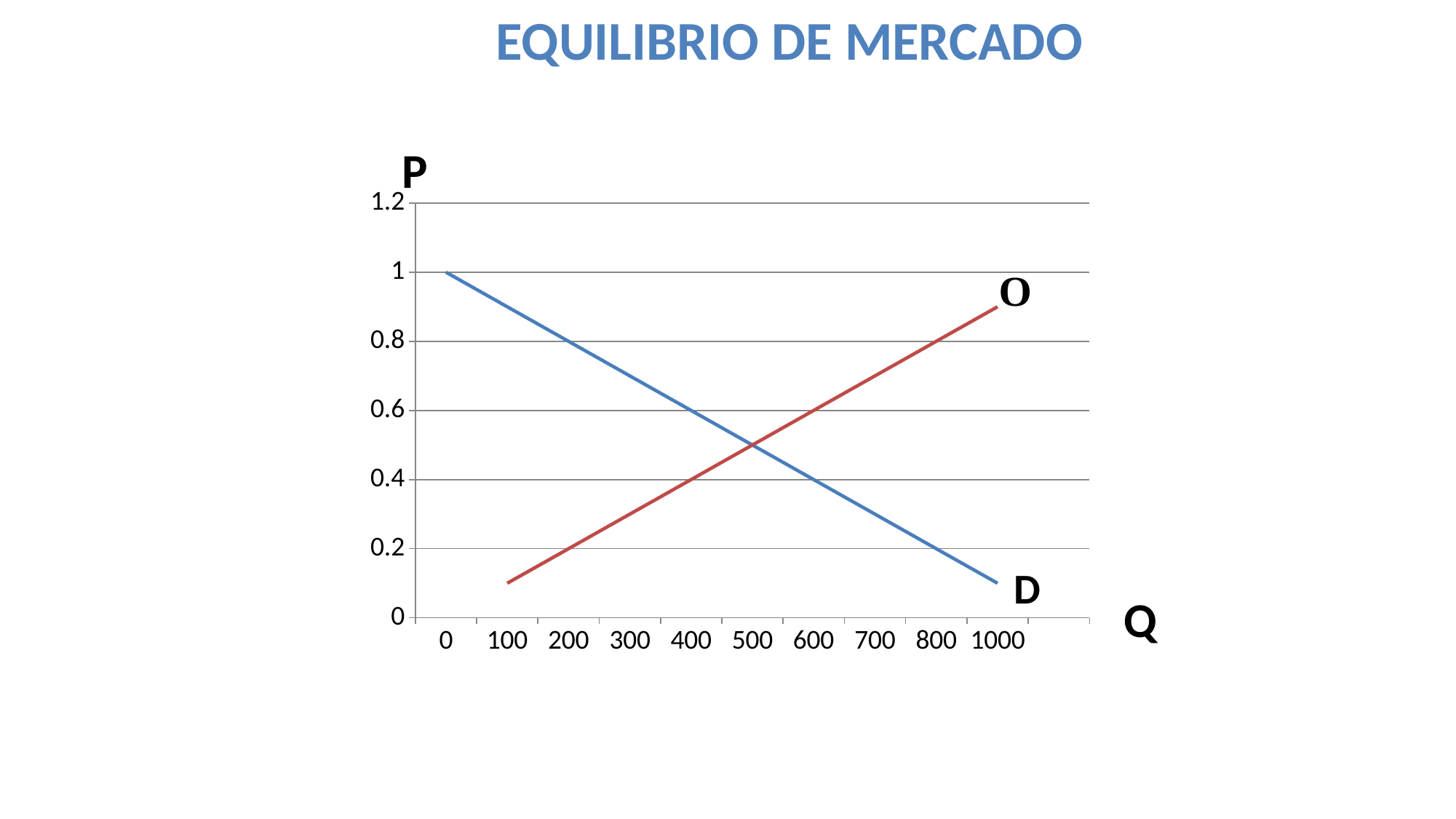
Is the value of the O line at Q = 800 greater or less than 0.6? greater Does the D line rise or fall as Q increases? fall What type of chart is shown on the slide? line chart What colour is the line labelled O? red Is the value of the D line at Q = 1000 greater or less than 0.2? less At Q = 200, which line has the higher value, D or O? D What is the value of the D line at Q = 0? 1 At Q = 800, which line has the higher value, D or O? O How many lines (series) are plotted on the chart? 2 Is the value of the D line at Q = 800 greater or less than 0.4? less Does the O line rise or fall as Q increases? rise What is the title of the chart? EQUILIBRIO DE MERCADO